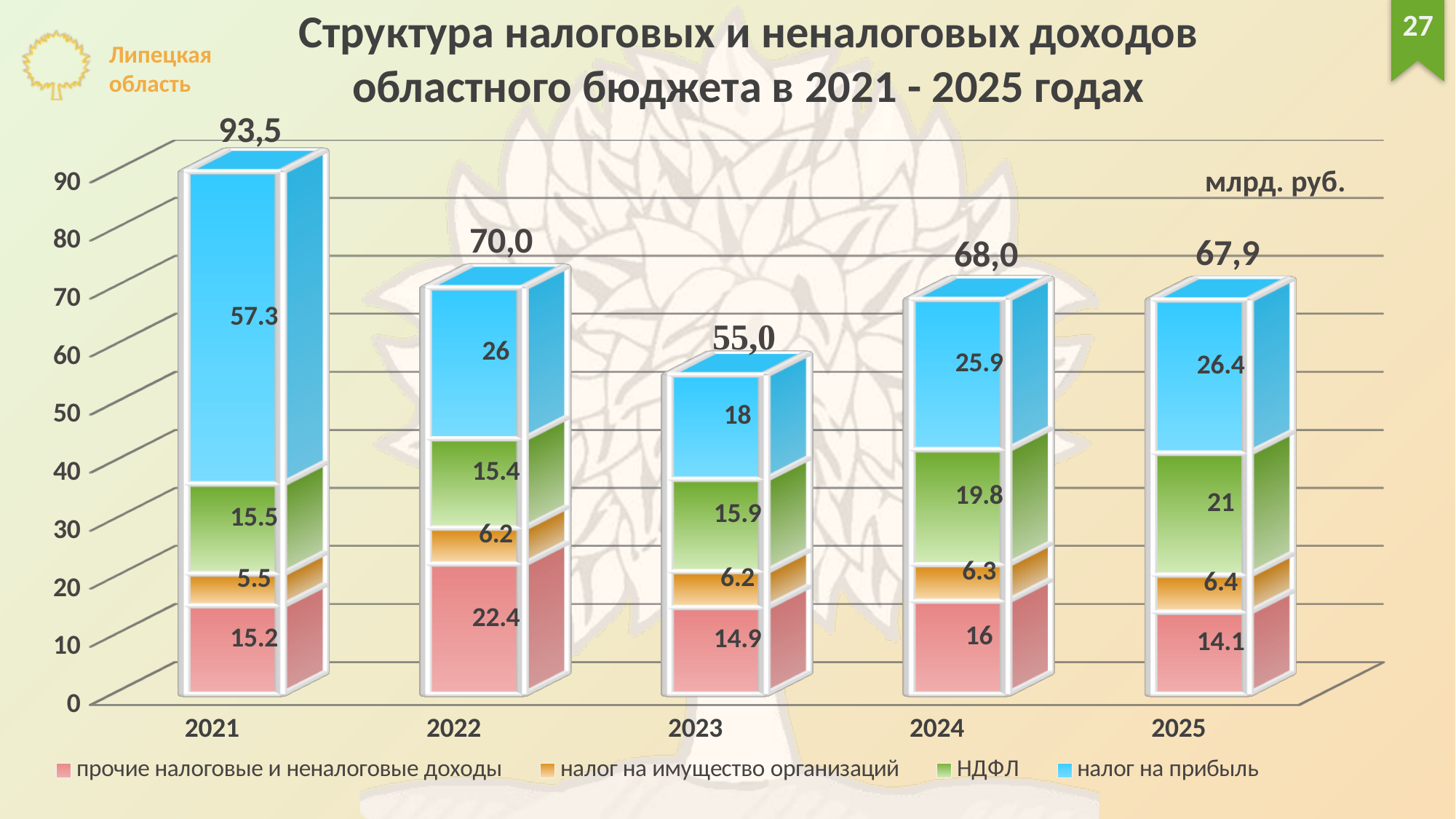
What is the difference between the налог на прибыль values for 2021 and 2022? 31.3 What kind of chart is shown on the slide? Stacked bar chart Which year has the highest total? 2021 Which year has the lowest total? 2023 What is the value of НДФЛ for 2024? 19.8 What is the total of the stacked bar for 2023? 55,0 How many years are shown on the x axis? 5 What is the value of налог на имущество организаций for 2025? 6.4 What is the value of налог на прибыль for 2021? 57.3 What is the value of прочие налоговые и неналоговые доходы for 2022? 22.4 How many series does the legend list? 4 Which is larger, НДФЛ in 2025 or НДФЛ in 2023? НДФЛ in 2025